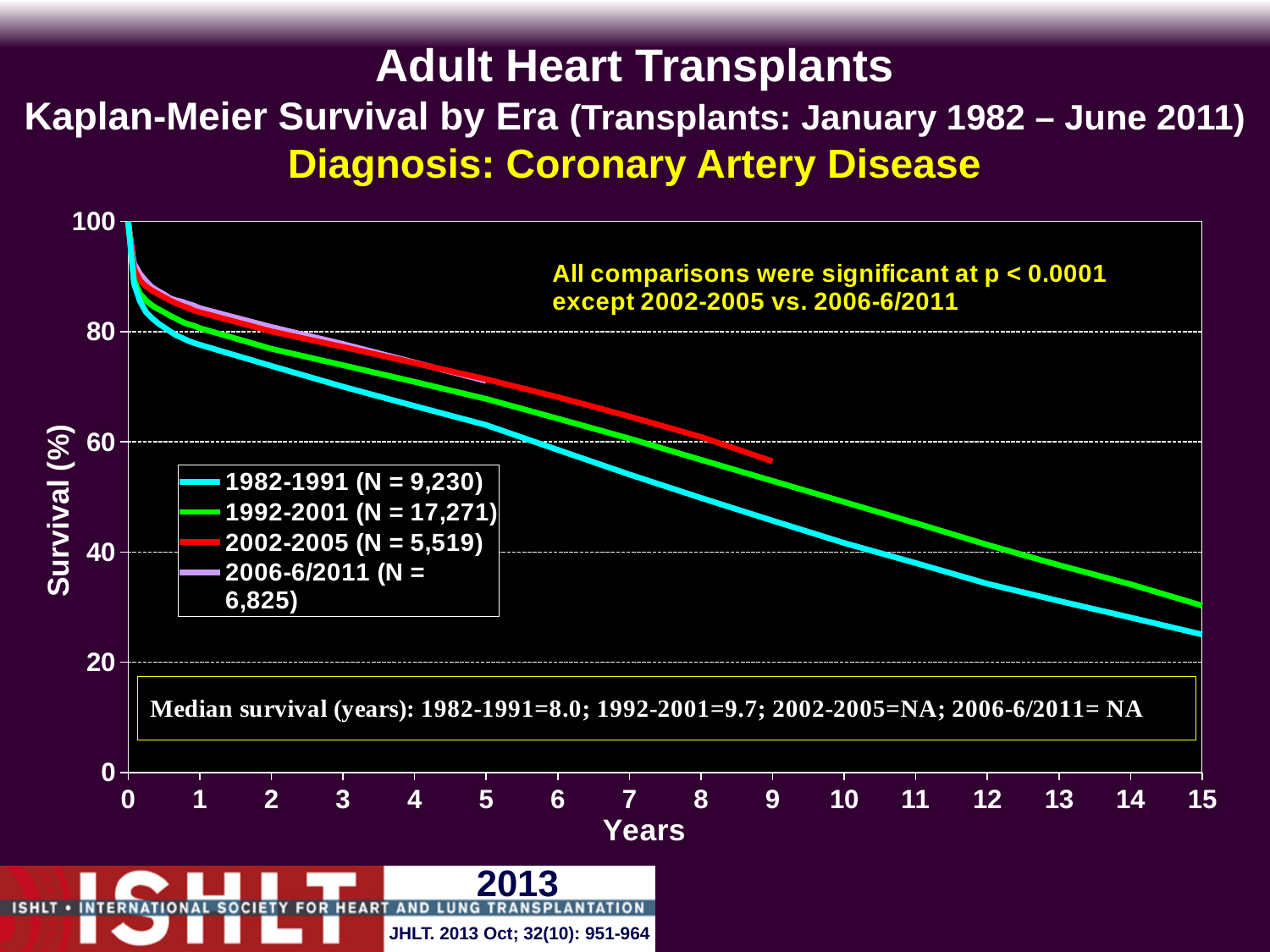
How many eras (series) does the legend list? 4 Which era's survival curve is the lowest across the chart? 1982-1991 What is the number of transplants (N) for the 1982-1991 era shown in the legend? 9,230 What kind of chart is shown on the slide? Line chart Is the survival for the 1982-1991 era at 15 years greater or less than 40%? less What is the median survival in years for the 1992-2001 era? 9.7 What is the difference in median survival (years) between the 1992-2001 era and the 1982-1991 era? 1.7 What is the median survival listed for the 2002-2005 era? NA How does survival change as years since transplant increase for every era? It falls What diagnosis is named in the chart title? Coronary Artery Disease At 10 years, which era has higher survival: 1982-1991 or 1992-2001? 1992-2001 Which era has the largest number of transplants (N) in the legend? 1992-2001 (N = 17,271)